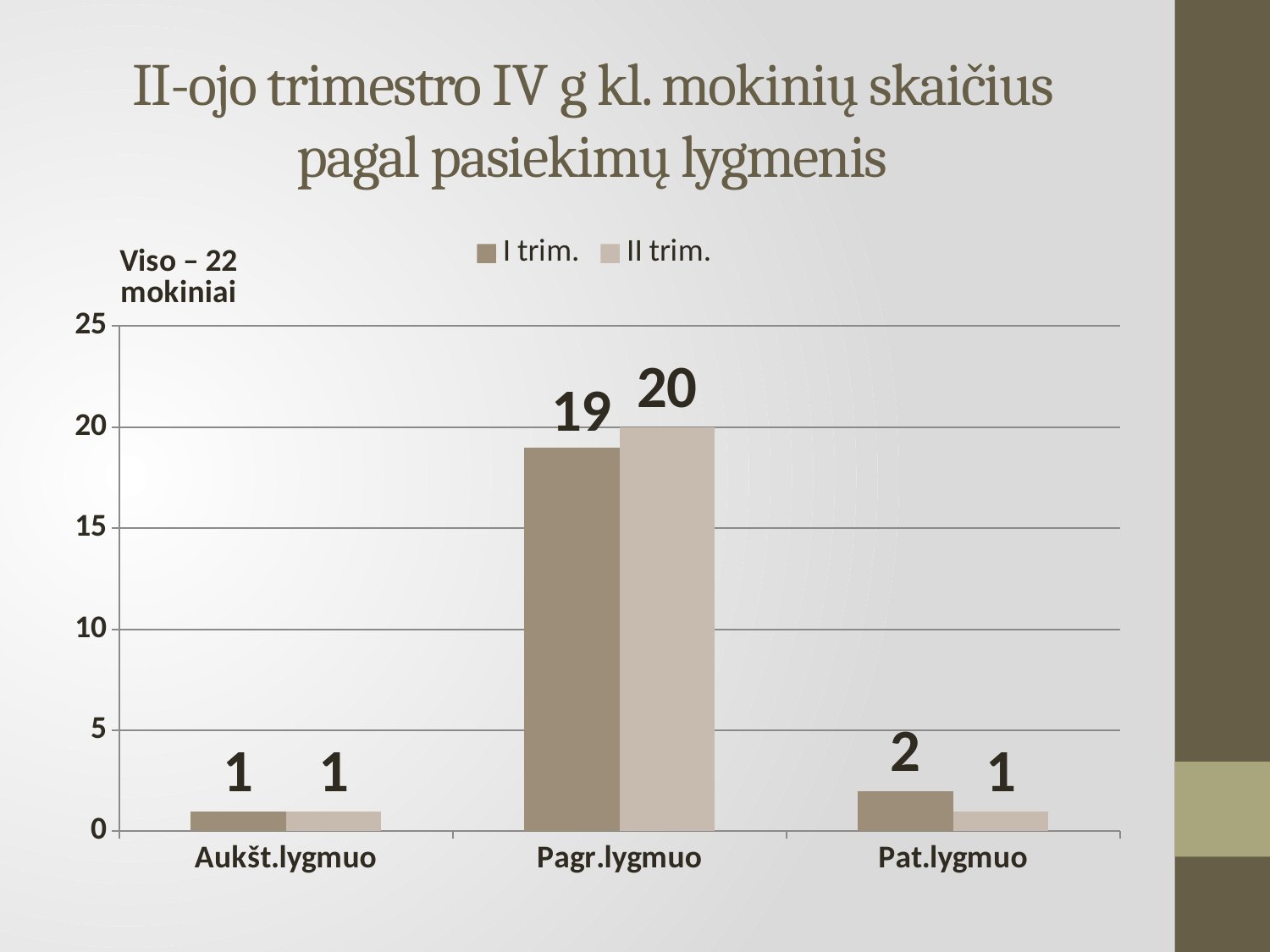
What is the value for I trim. in the Pagr.lygmuo category? 19 What is the value for II trim. in the Aukšt.lygmuo category? 1 Is the I trim. value for Pagr.lygmuo greater or less than 15? greater What kind of chart is shown on the slide? bar chart How many categories are shown on the x axis? 3 Which category has the lowest value for I trim.? Aukšt.lygmuo Which category has the highest value for II trim.? Pagr.lygmuo Which is larger for Pat.lygmuo: the I trim. value or the II trim. value? I trim. What is the value for I trim. in the Pat.lygmuo category? 2 How many series does the legend list? 2 What is the difference between the II trim. and I trim. values for Pagr.lygmuo? 1 What is the value for II trim. in the Pagr.lygmuo category? 20